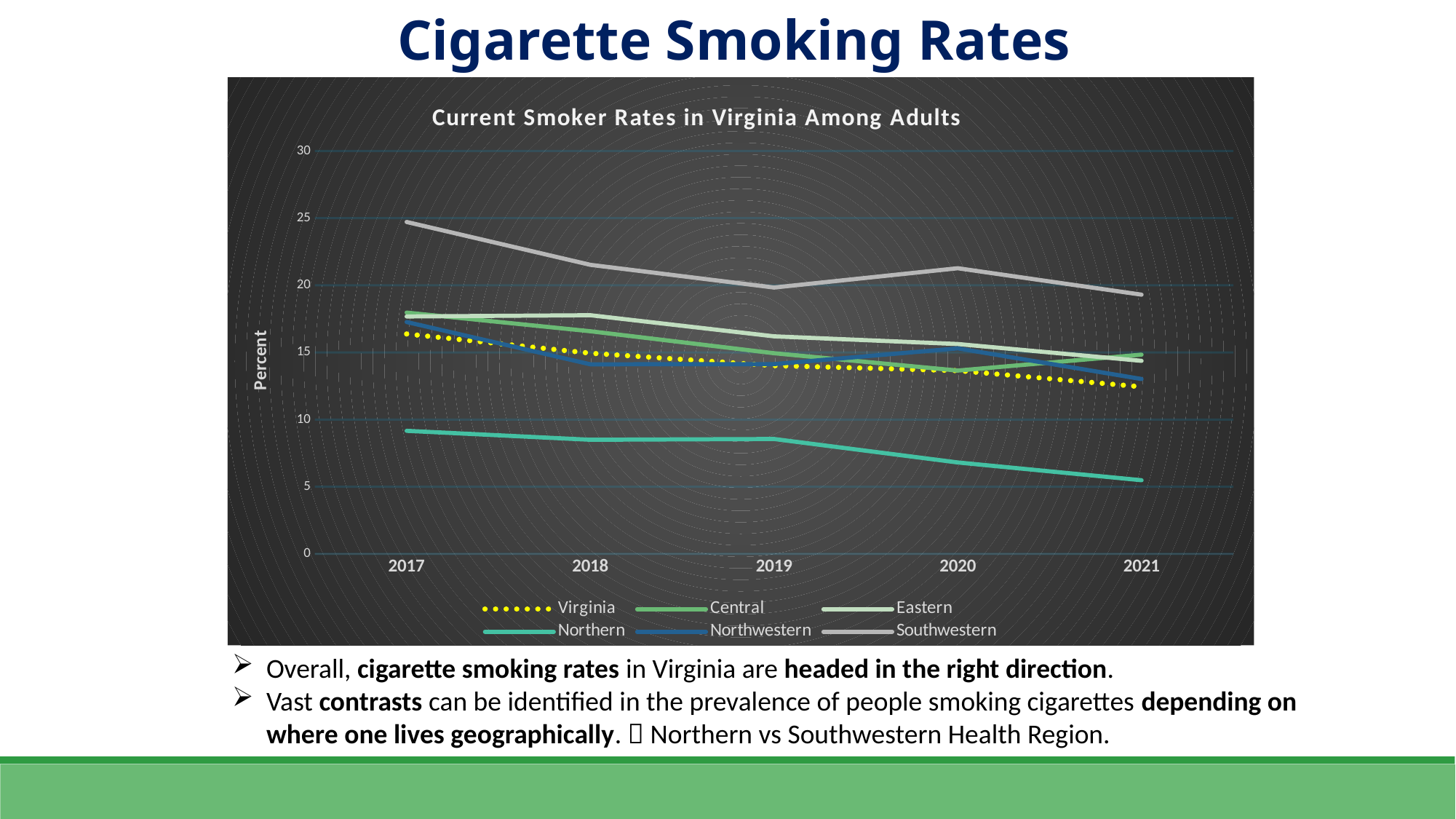
Which region has the lowest smoking rate in 2021? Northern Which region has the highest smoking rate in 2017? Southwestern Is the value for Eastern in 2017 greater or less than 15? greater How many series does the legend list? 6 Is the value for Virginia in 2021 greater or less than 15? less Is the value for Northern in 2021 greater or less than 10? less Does the Northern line rise or fall from 2017 to 2021? fall What is the title of the chart? Current Smoker Rates in Virginia Among Adults In 2021, which is larger, the value for Southwestern or the value for Northern? Southwestern What kind of chart is shown on the slide? line chart How many years are shown on the x axis? 5